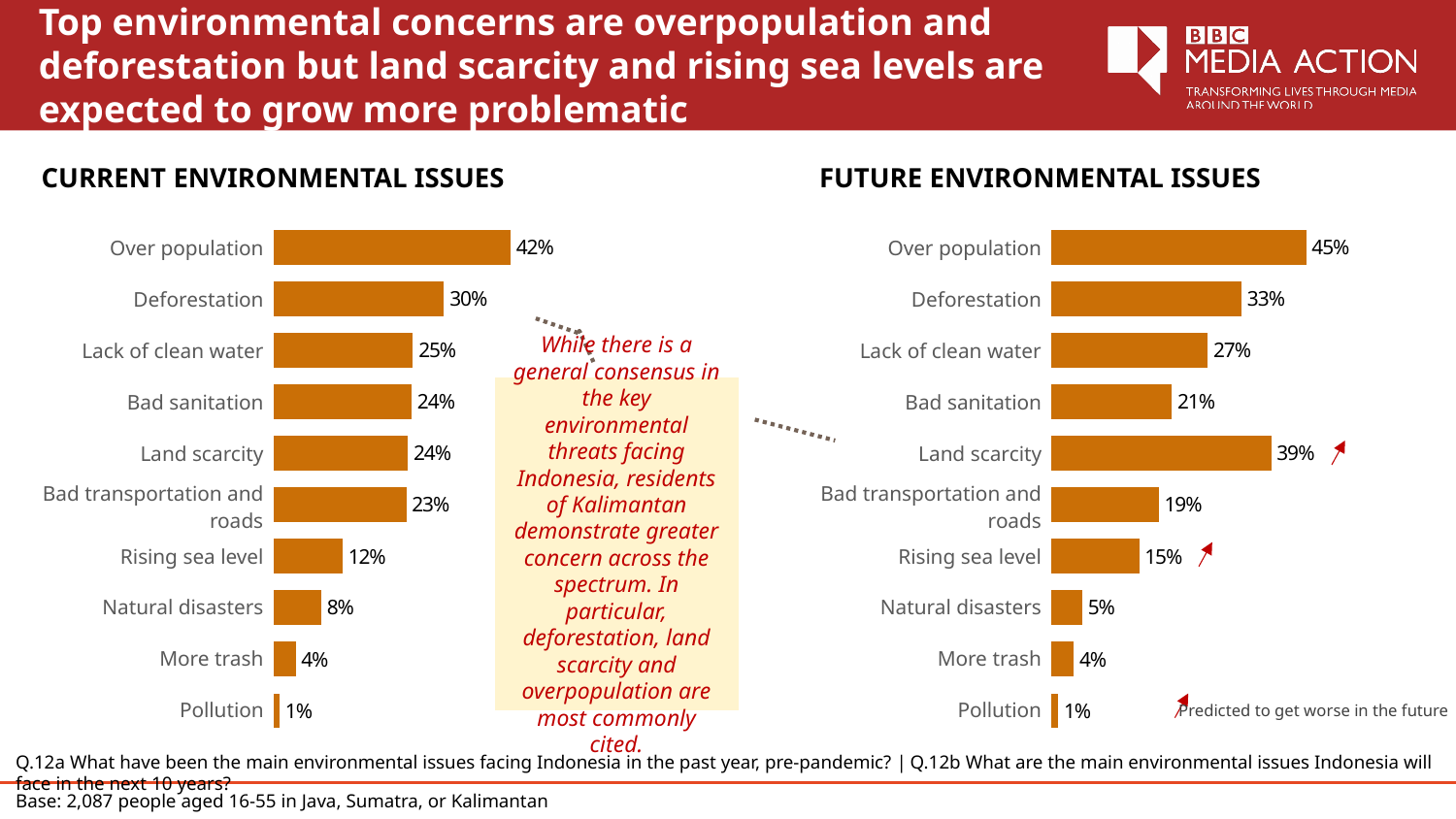
In the Future Environmental Issues chart, what does the red arrow next to a bar indicate? Predicted to get worse in the future In the Current Environmental Issues chart, what is the difference between Over population and Deforestation? 12% In the Future Environmental Issues chart, what is the value for Rising sea level? 15% In the Future Environmental Issues chart, what is the value for Land scarcity? 39% In the Future Environmental Issues chart, which is larger: Deforestation or Lack of clean water? Deforestation What is the difference between the Future and Current values for Land scarcity? 15% Is the value for Bad sanitation larger in the Current Environmental Issues chart or the Future Environmental Issues chart? Current Environmental Issues In the Current Environmental Issues chart, what is the value for Over population? 42% What kind of chart is the Future Environmental Issues chart? Bar chart In the Current Environmental Issues chart, which category has the highest value? Over population How many categories are shown in the Current Environmental Issues chart? 10 In the Future Environmental Issues chart, which category has the lowest value? Pollution